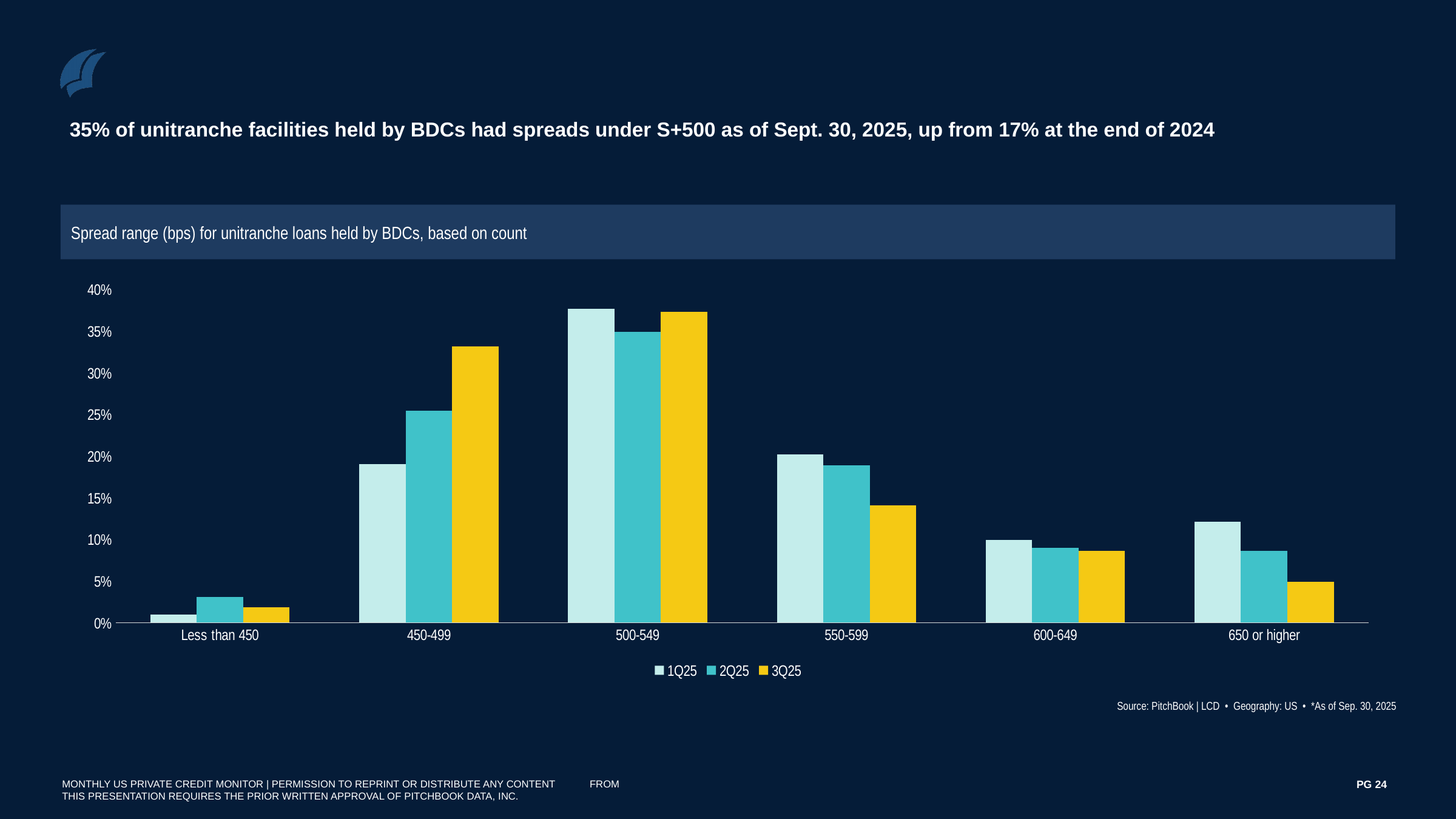
Is the 1Q25 value for 450-499 greater or less than 20%? less What kind of chart is shown on the slide? Bar chart Is the 2Q25 value for 500-549 greater or less than 30%? greater Which spread range has the lowest 3Q25 value? Less than 450 For the 450-499 spread range, which is larger: the 1Q25 value or the 3Q25 value? 3Q25 Which spread range has the highest 3Q25 value? 500-549 What are the three series listed in the legend? 1Q25, 2Q25, 3Q25 For the 650 or higher spread range, which is larger: the 1Q25 value or the 3Q25 value? 1Q25 Is the 3Q25 value for 450-499 greater or less than 30%? greater How many series does the legend list? 3 How many spread range categories are shown on the x axis? 6 Do the 3Q25 values rise or fall across the spread ranges from 500-549 to 650 or higher? fall